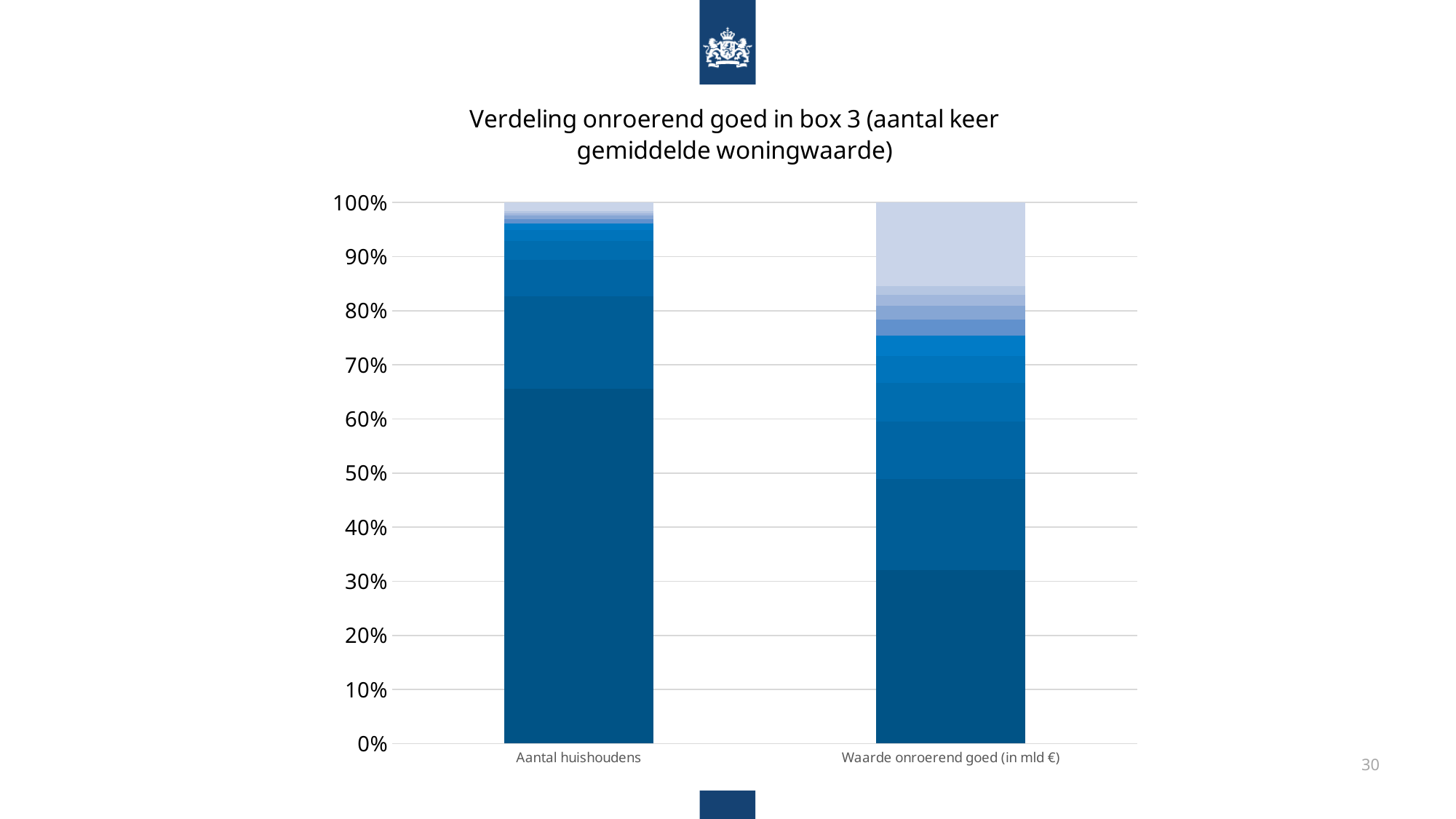
What is the total height of the stacked bar for Aantal huishoudens? 100% What kind of chart is shown on the slide? Stacked bar chart What is the total height of the stacked bar for Waarde onroerend goed (in mld €)? 100% How many categories are shown on the x axis of the chart? 2 Is the bottom (darkest) segment of the Waarde onroerend goed (in mld €) bar greater or less than 40%? less Is the top (lightest) segment of the Waarde onroerend goed (in mld €) bar greater or less than 10%? greater What are the two category labels on the x axis? Aantal huishoudens; Waarde onroerend goed (in mld €) Is the bottom (darkest) segment of the Waarde onroerend goed (in mld €) bar greater or less than 30%? greater Which bar has the larger top (lightest) segment: Aantal huishoudens or Waarde onroerend goed (in mld €)? Waarde onroerend goed (in mld €) Which bar has the larger bottom (darkest) segment: Aantal huishoudens or Waarde onroerend goed (in mld €)? Aantal huishoudens What is the title of the chart? Verdeling onroerend goed in box 3 (aantal keer gemiddelde woningwaarde)